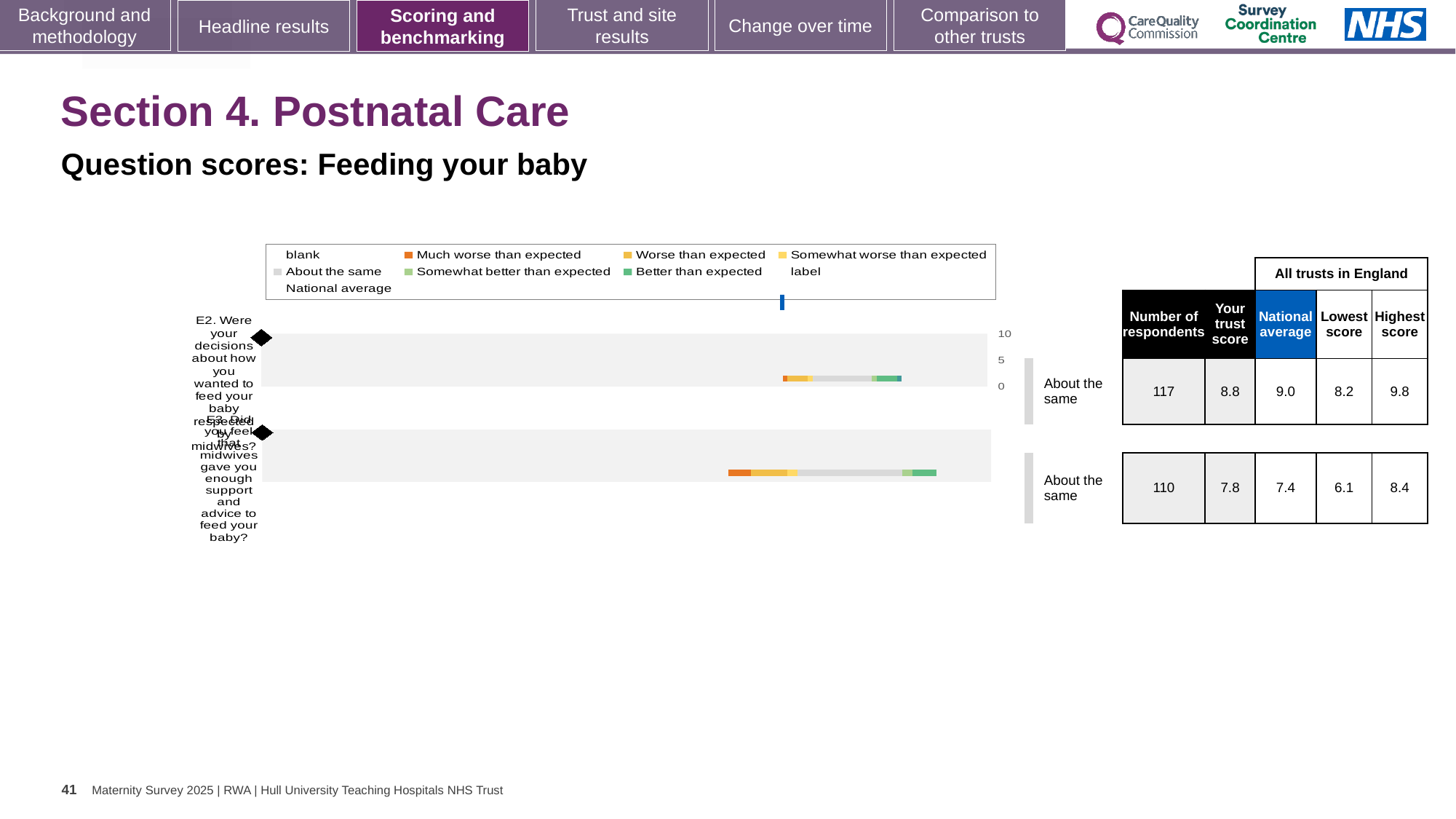
What colour in the legend represents 'Much worse than expected'? orange What colour in the legend represents 'Better than expected'? green What is the highest score among all trusts in England for question E2? 9.8 What is the trust score for question E3 about midwives giving enough support and advice to feed your baby? 7.8 What benchmark category is shown for question E2? About the same What is the national average for question E2? 9.0 For question E3, which is larger: the trust score or the national average? the trust score How many questions (categories) are plotted in the chart? 2 What type of chart is shown on the slide? bar chart What is the number of respondents for question E2 about decisions on how to feed your baby being respected by midwives? 117 What is the lowest score among all trusts in England for question E3? 6.1 What is the difference between the highest and lowest scores for question E3? 2.3